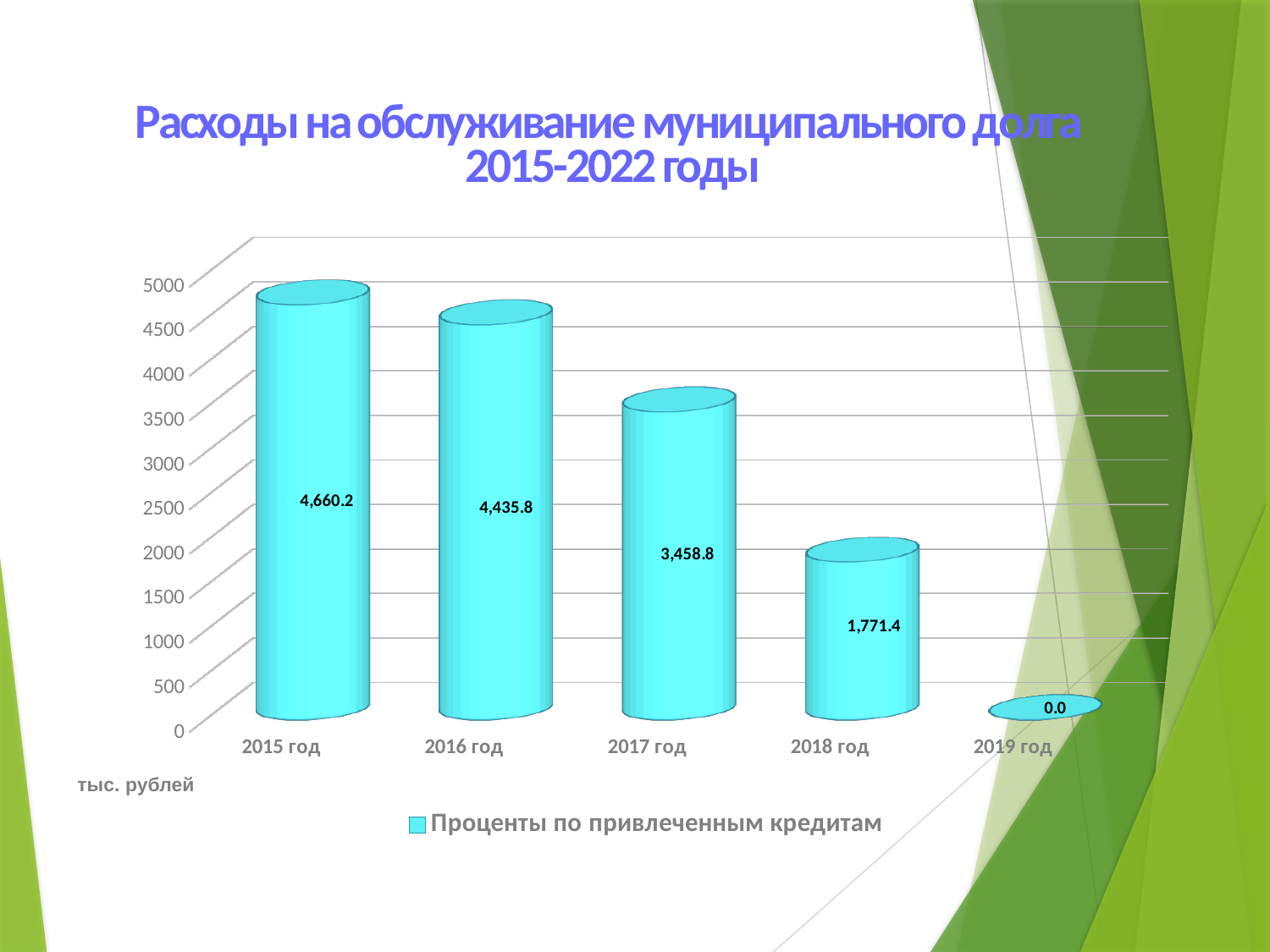
What is the value for 2017 год? 3,458.8 How many years are shown on the x axis? 5 Which year has the highest value? 2015 год What is the value for 2015 год? 4,660.2 Is the value for 2018 год greater or less than 2000? less Which year has the lowest value? 2019 год What is the difference between the values for 2017 год and 2018 год? 1,687.4 What is the value for 2019 год? 0.0 Which is larger, the value for 2016 год or the value for 2018 год? 2016 год Do the values rise or fall from 2015 год to 2019 год? fall What kind of chart is shown on the slide? bar chart What is the difference between the values for 2015 год and 2016 год? 224.4